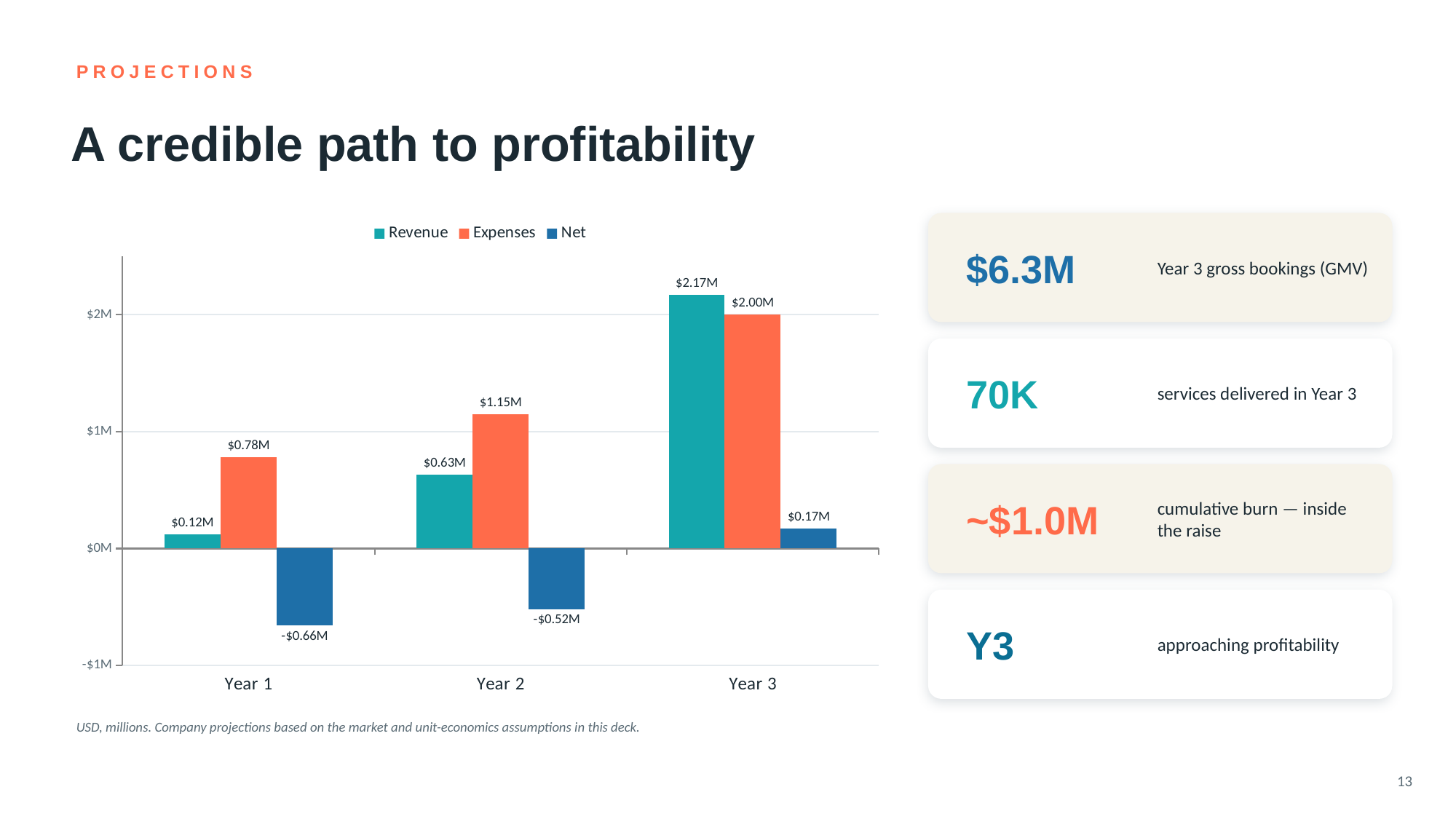
Which year has the lowest Net value? Year 1 What is the difference between Revenue and Expenses in Year 3? $0.17M What is the Net value for Year 3? $0.17M What kind of chart is shown on the slide? Bar chart How many series does the legend list? 3 What is the Expenses value for Year 2? $1.15M Which year has the highest Revenue? Year 3 Is the Revenue value for Year 3 greater or less than $2M? greater Which is larger in Year 2, Revenue or Expenses? Expenses What is the Revenue value for Year 1? $0.12M What is the Net value for Year 1? -$0.66M How many years are shown on the x axis? 3